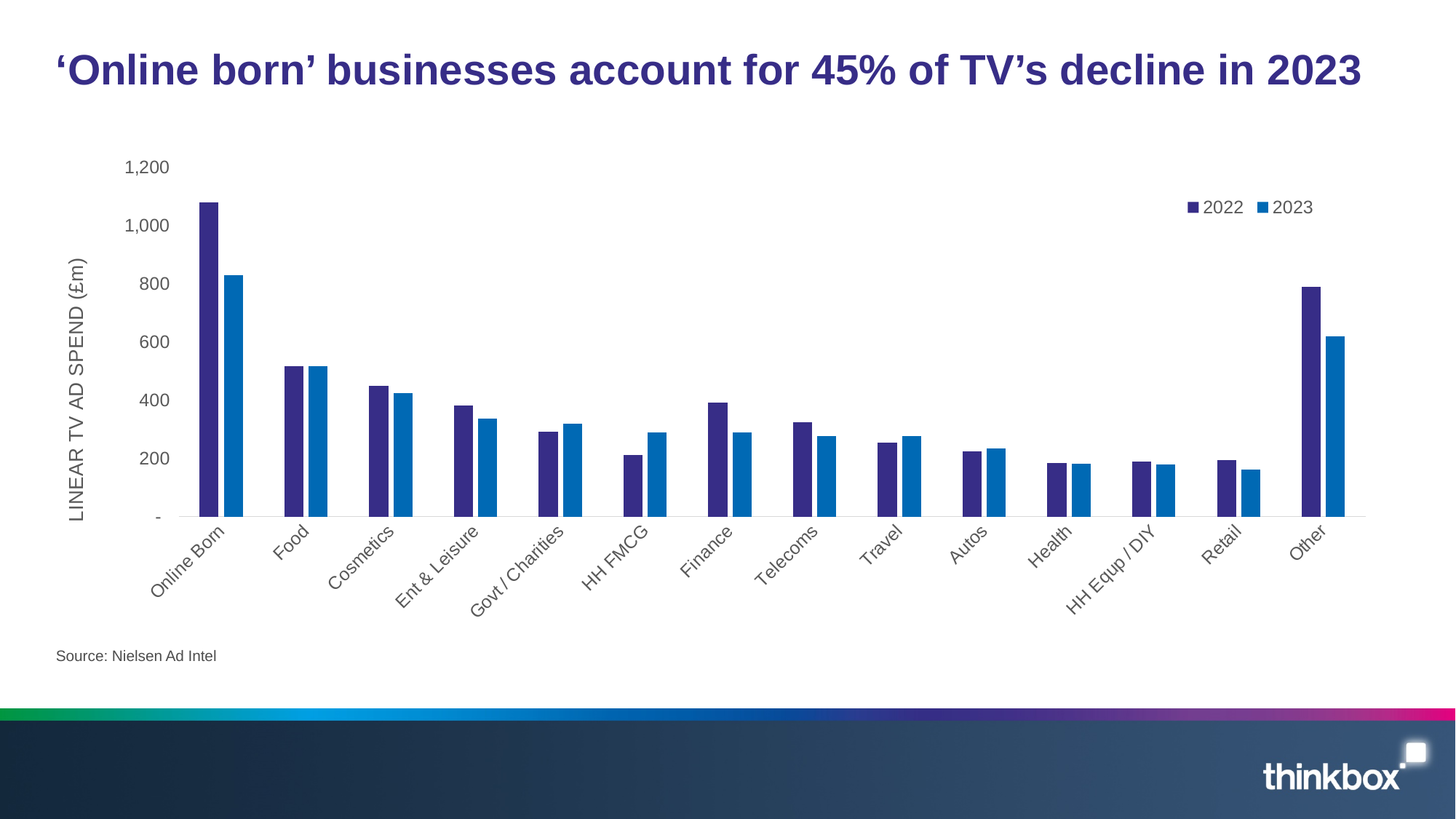
Is the 2023 value for Telecoms greater or less than 400? less For HH FMCG, which year has the larger linear TV ad spend, 2022 or 2023? 2023 Is the 2023 value for Online Born greater or less than 1,000? less Is the 2022 value for Cosmetics greater or less than 400? greater Which category has the highest 2022 linear TV ad spend? Online Born How many categories are shown on the x axis? 14 For Finance, which year has the larger linear TV ad spend, 2022 or 2023? 2022 What kind of chart is shown on the slide? Bar chart What is the label of the y axis? LINEAR TV AD SPEND (£m) Which category has the highest 2023 linear TV ad spend? Online Born How many series does the legend list? 2